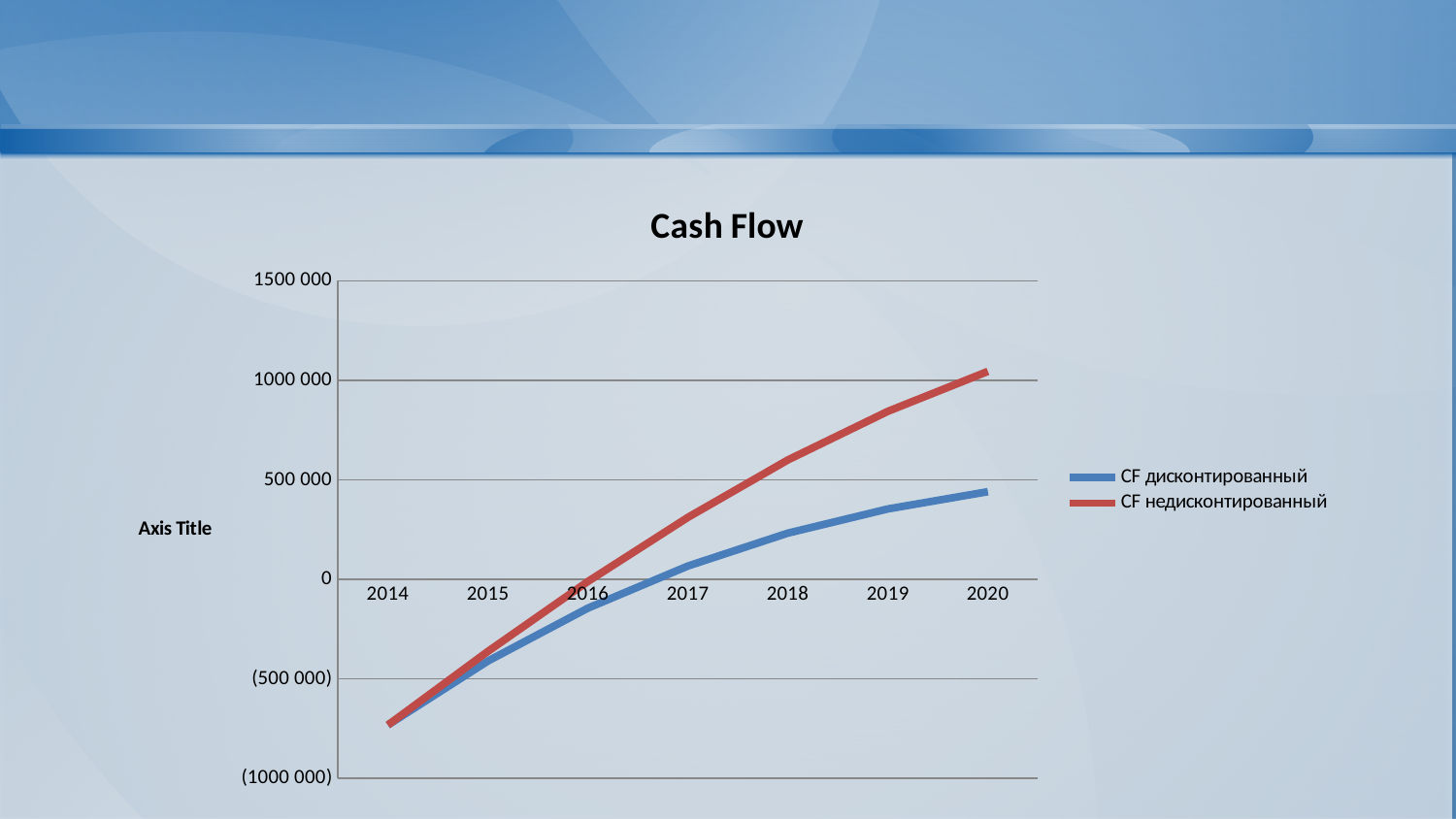
How many series does the legend list? 2 In which year is CF дисконтированный at its highest? 2020 Is the value for CF недисконтированный in 2014 greater or less than (500 000)? less Which series is drawn in red? CF недисконтированный What is the title of the chart? Cash Flow What kind of chart is shown on the slide? line chart Do the values of CF недисконтированный rise or fall from 2014 to 2020? rise Is the value for CF дисконтированный in 2020 greater or less than 500 000? less Is the value for CF недисконтированный in 2018 greater or less than 500 000? greater In which year is CF недисконтированный at its lowest? 2014 In 2020, which series has the larger value, CF дисконтированный or CF недисконтированный? CF недисконтированный How many years are plotted along the x axis? 7